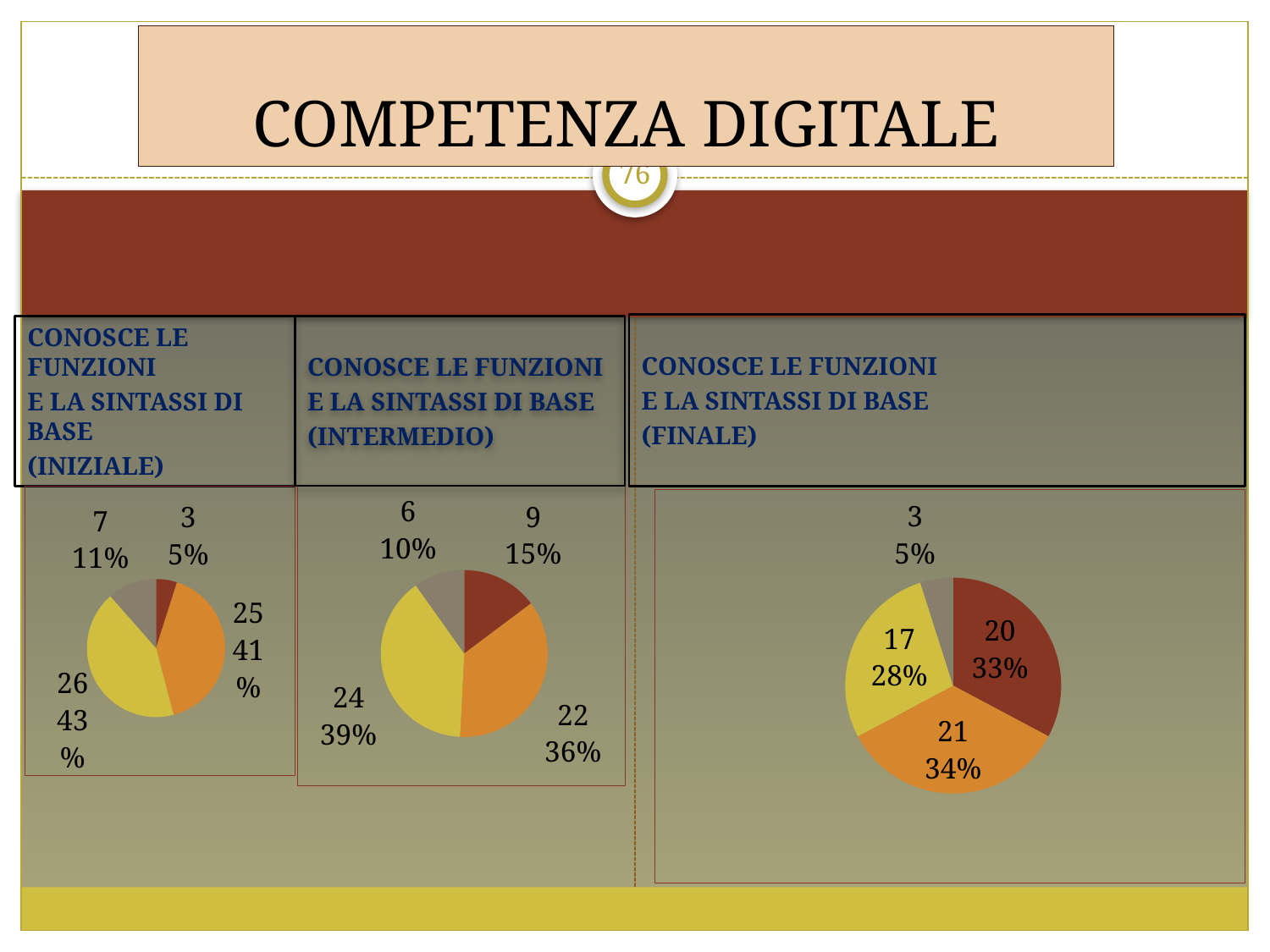
How many slices does the INIZIALE pie chart have? 4 In the INIZIALE pie chart, what count is shown for the orange slice? 25 In the INIZIALE pie chart, what percentage is shown for the largest slice? 43% How many pie charts are shown on the slide? 3 In the FINALE pie chart, which slice is larger: the yellow slice or the orange slice? the orange slice In the FINALE pie chart, what count is shown for the dark red slice? 20 What kind of chart is used in the INIZIALE panel? pie chart In the INTERMEDIO pie chart, what is the difference between the counts of the yellow slice (24) and the orange slice (22)? 2 In the FINALE pie chart, what share of the pie does the grey slice represent? 5% In the INIZIALE pie chart, what count is shown for the smallest slice? 3 In the INTERMEDIO pie chart, what percentage is shown for the yellow slice? 39% In the INTERMEDIO pie chart, what percentage is shown for the smallest slice? 10%